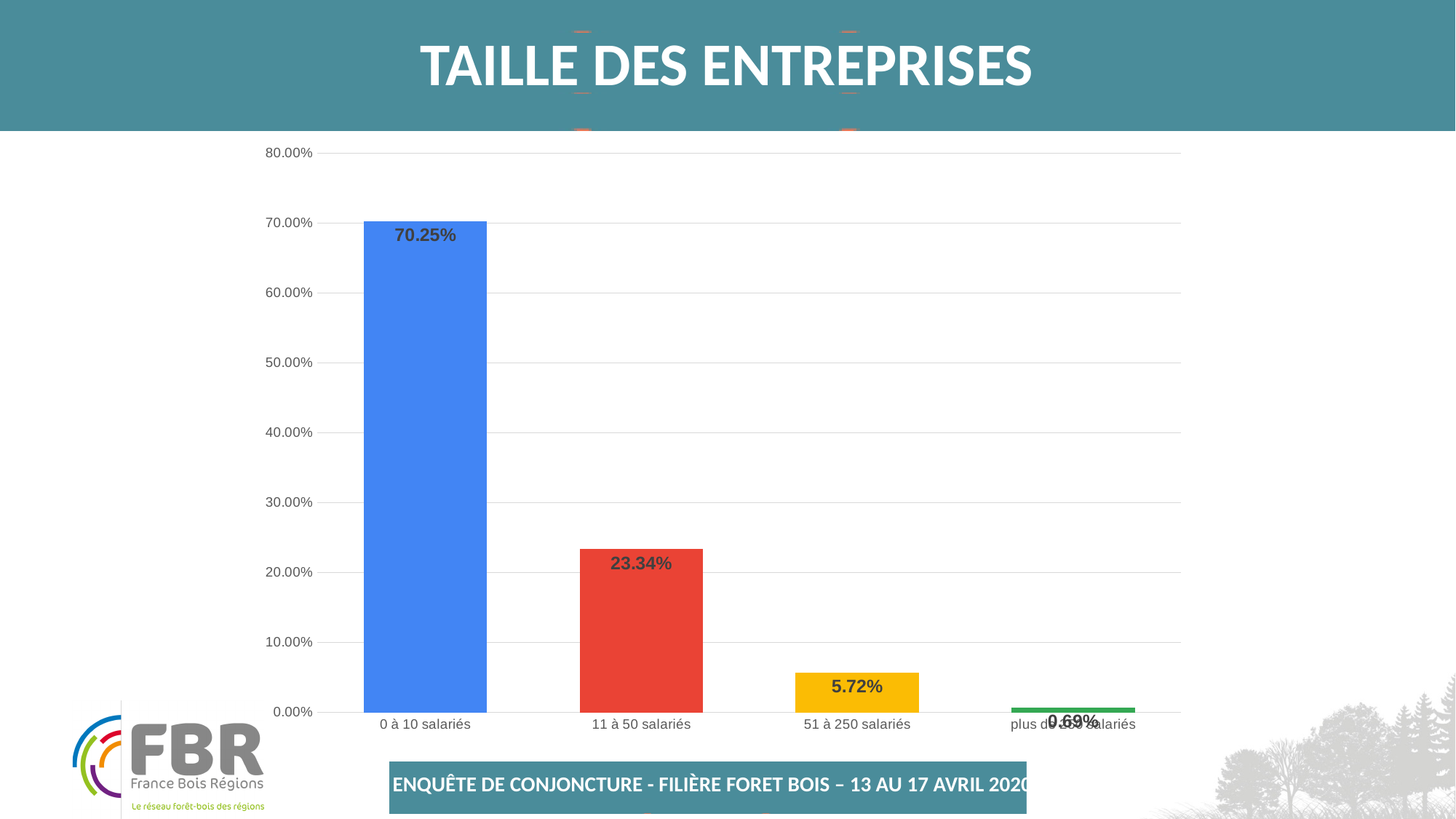
Do the values rise or fall from left to right along the x axis? fall How many categories are shown on the x axis? 4 What is the value for "51 à 250 salariés"? 5.72% Which category has the highest value? 0 à 10 salariés What value is printed on the rightmost (green) bar? 0.69% Which is larger, the value for "11 à 50 salariés" or for "51 à 250 salariés"? 11 à 50 salariés Which category has the lowest value? plus de 250 salariés What is the value for "11 à 50 salariés"? 23.34% What is the difference between the values for "0 à 10 salariés" and "11 à 50 salariés"? 46.91 percentage points What is the value for "0 à 10 salariés"? 70.25% Is the value for "0 à 10 salariés" greater or less than 60.00%? greater What kind of chart is shown on the slide? bar chart